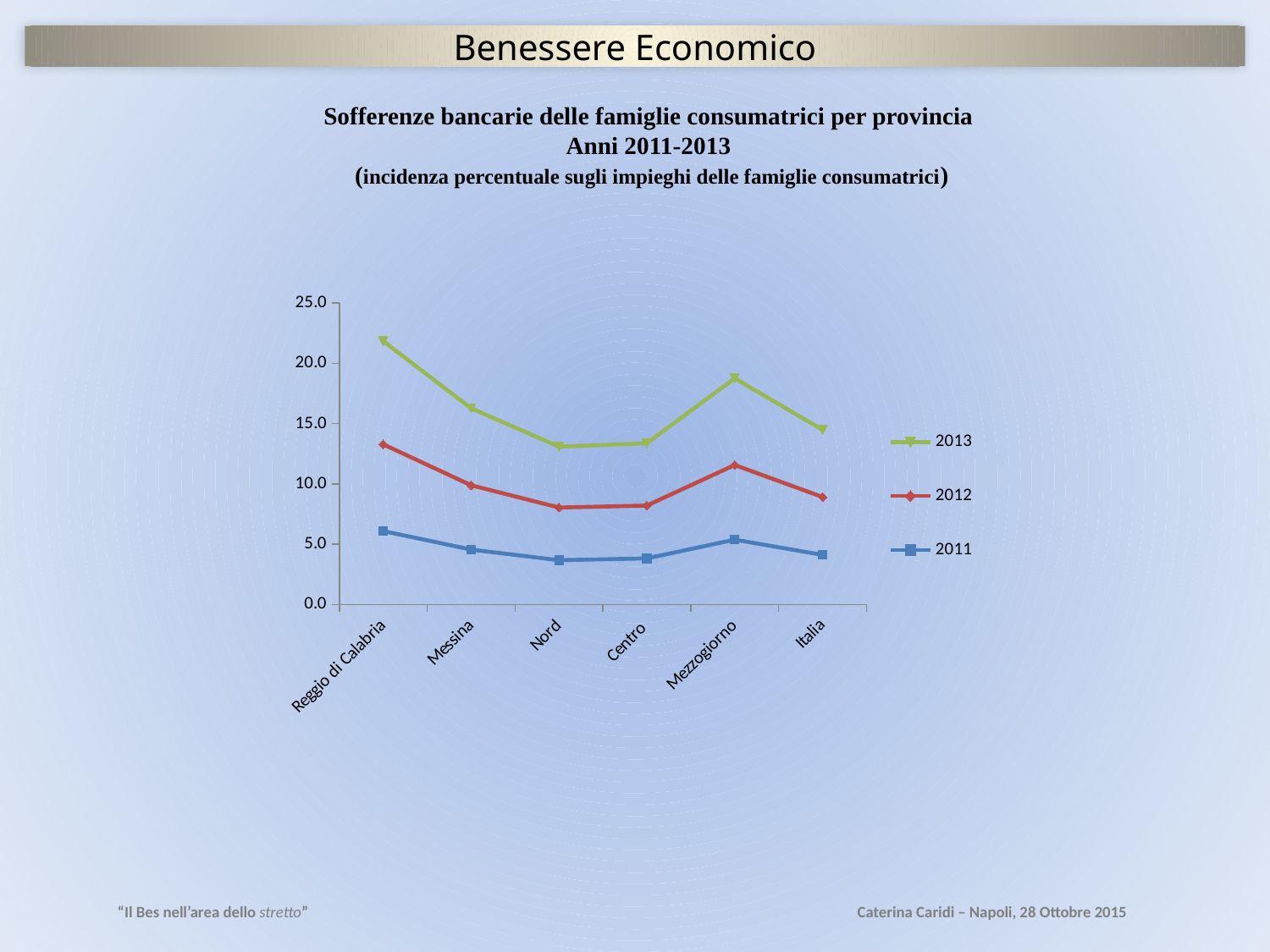
How many categories are shown on the x axis? 6 What kind of chart is shown on the slide? Line chart For the 2013 series, which is larger: the value for Mezzogiorno or the value for Italia? Mezzogiorno Is the 2011 value for Messina greater or less than 5.0? less Which category has the highest value for the 2011 series? Reggio di Calabria How many series does the legend list? 3 Is the 2013 value for Nord greater or less than 15.0? less Does the 2013 series rise or fall from Reggio di Calabria to Nord? Fall Which category has the highest value for the 2013 series? Reggio di Calabria Which series is drawn in green? 2013